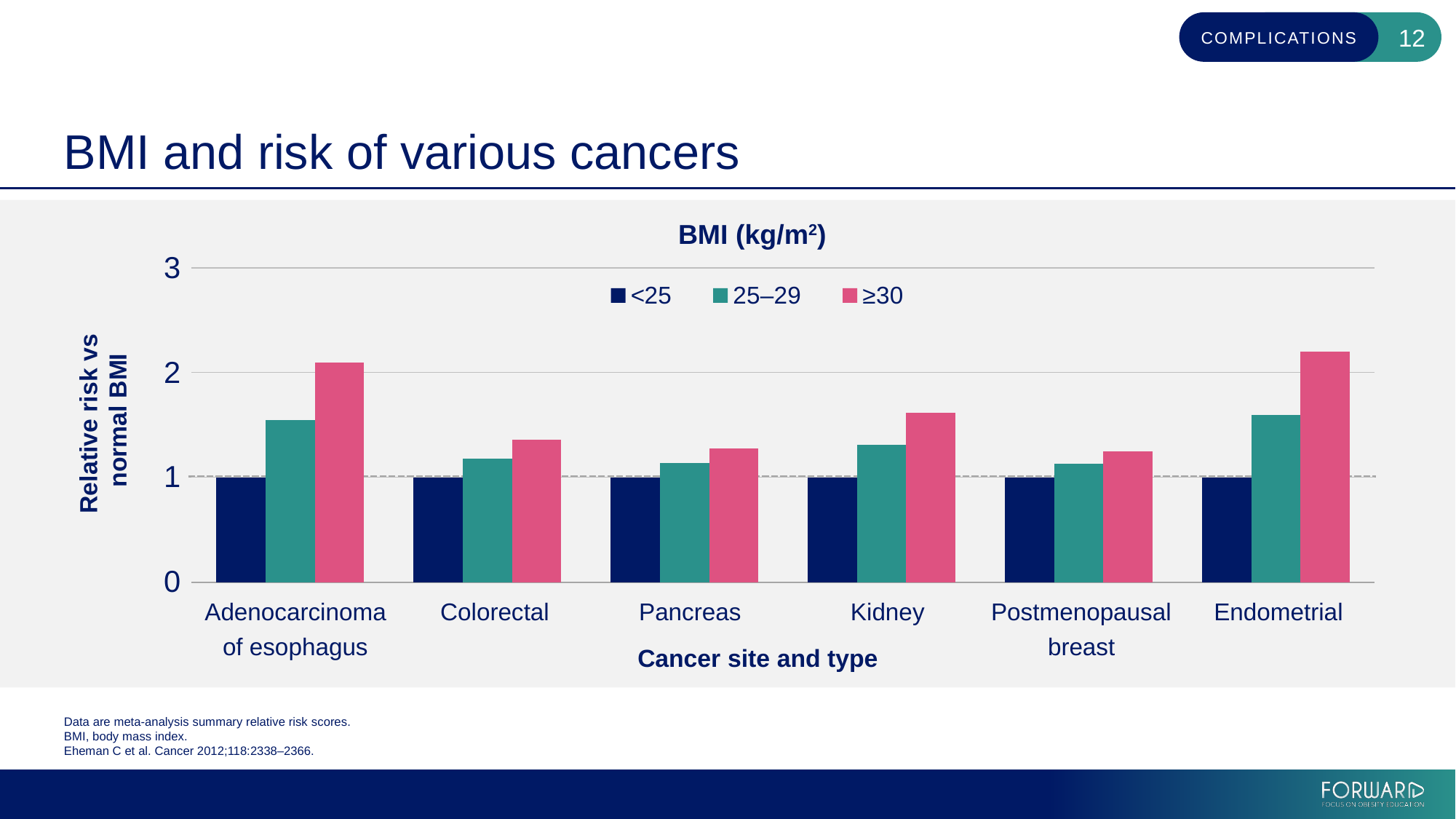
What is the relative risk for Endometrial cancer in the <25 BMI group? 1 How many series does the legend list? 3 What is the relative risk for Kidney cancer in the <25 BMI group? 1 Is the value for Colorectal cancer in the ≥30 BMI group greater or less than 2? less How many cancer sites/types are shown on the x axis? 6 What are the three BMI groups listed in the legend? <25, 25–29, ≥30 Is the value for Endometrial cancer in the ≥30 BMI group greater or less than 2? greater What kind of chart is shown on the slide? bar chart Which is larger: the ≥30 BMI value for Adenocarcinoma of esophagus or for Kidney cancer? Adenocarcinoma of esophagus Is the value for Pancreas cancer in the 25–29 BMI group greater or less than 1? greater For Endometrial cancer, do the values rise or fall going from the <25 group to the ≥30 group? rise Which is larger: the ≥30 BMI value for Kidney cancer or for Colorectal cancer? Kidney